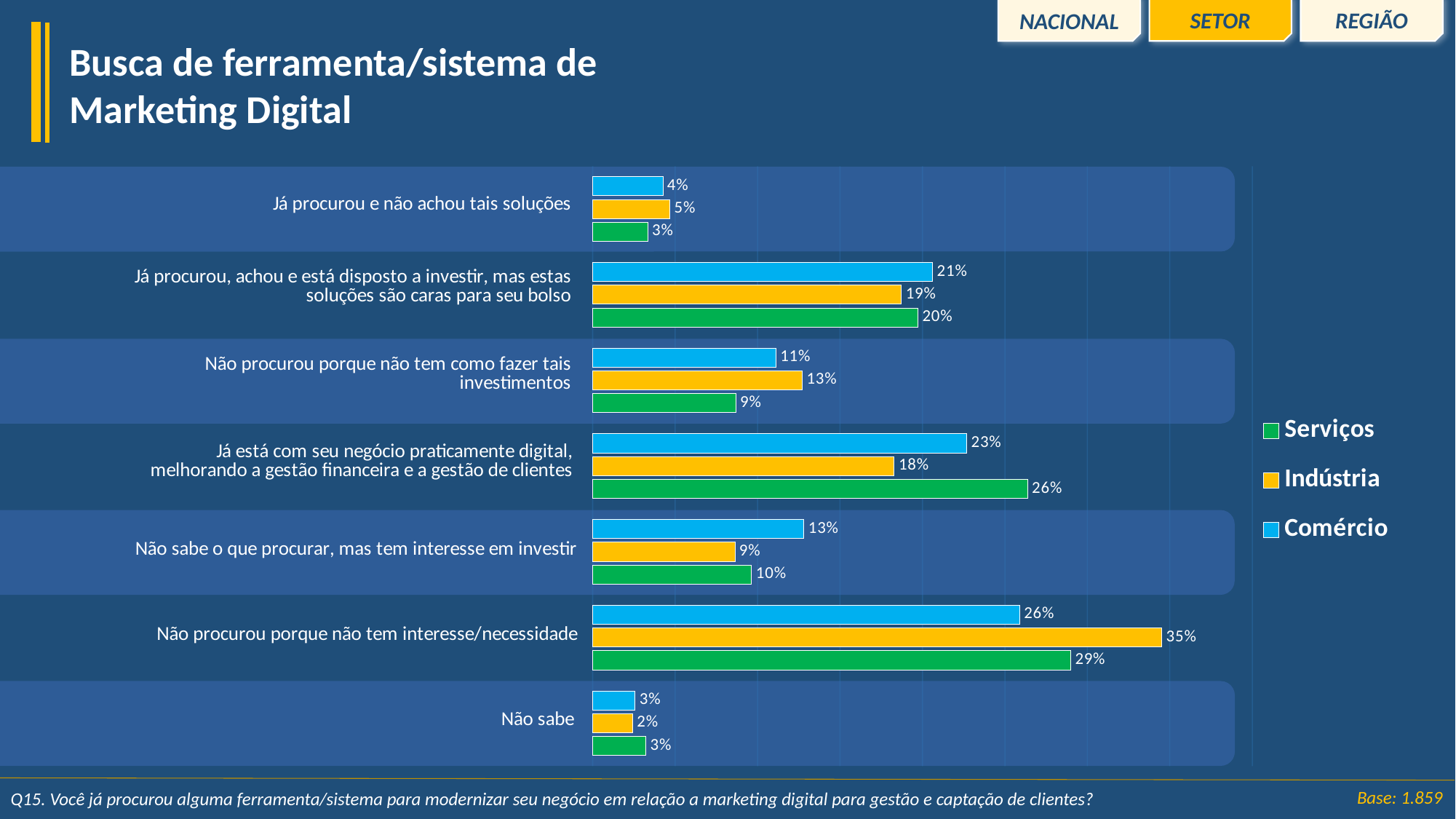
What is the Indústria value for "Não procurou porque não tem interesse/necessidade"? 35% For "Não procurou porque não tem como fazer tais investimentos", which is larger: the Indústria value or the Serviços value? Indústria What is the Serviços value for "Já está com seu negócio praticamente digital, melhorando a gestão financeira e a gestão de clientes"? 26% What is the difference between the Indústria and Comércio values for "Não procurou porque não tem interesse/necessidade"? 9% What kind of chart is shown on the slide? Bar chart Which category has the lowest Indústria value? Não sabe How many categories are shown in the chart? 7 What is the difference between the Serviços and Indústria values for "Já está com seu negócio praticamente digital, melhorando a gestão financeira e a gestão de clientes"? 8% Which category has the highest Indústria value? Não procurou porque não tem interesse/necessidade How many series does the legend list? 3 Which colour represents the Comércio series in the legend? Blue What is the Comércio value for "Não sabe o que procurar, mas tem interesse em investir"? 13%